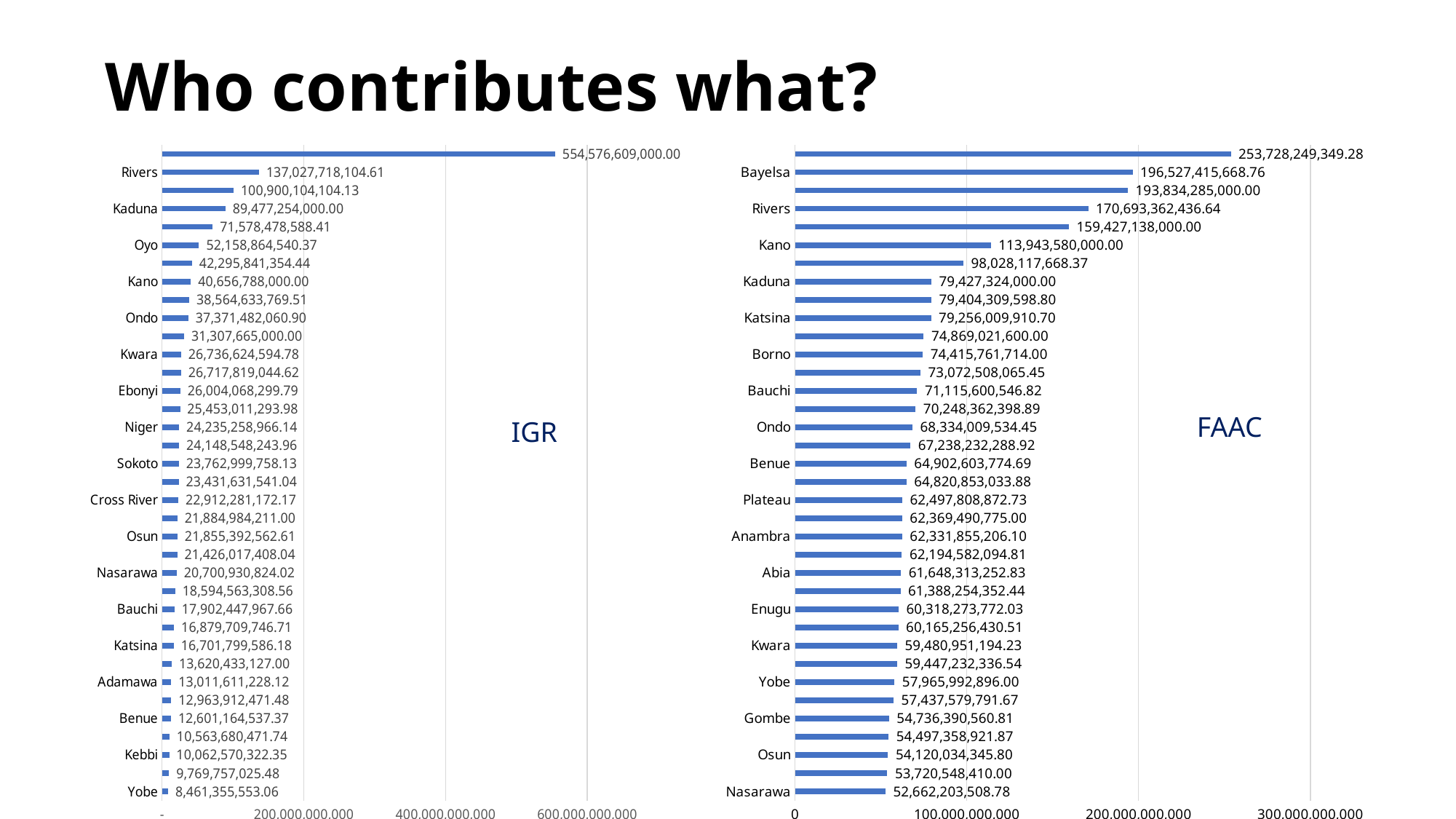
On the IGR chart, what is the value for Rivers? 137,027,718,104.61 On the FAAC chart, what is the value for Bayelsa? 196,527,415,668.76 What are the titles of the two charts on the slide? IGR and FAAC On the FAAC chart, what is the value for Nasarawa? 52,662,203,508.78 On the FAAC chart, is the value for Kano greater or less than 100,000,000,000? greater On the IGR chart, what is the value for Kaduna? 89,477,254,000.00 What type of chart is used on the left side of the slide? Bar chart Is the value for Rivers larger on the IGR chart or on the FAAC chart? FAAC On the IGR chart, is the value for Rivers greater or less than 200,000,000,000? less On the IGR chart, which labelled state has the lowest value? Yobe On the IGR chart, what is the difference between the values for Kaduna and Kano? 48,820,466,000.00 On the FAAC chart, what is the value of the longest bar? 253,728,249,349.28